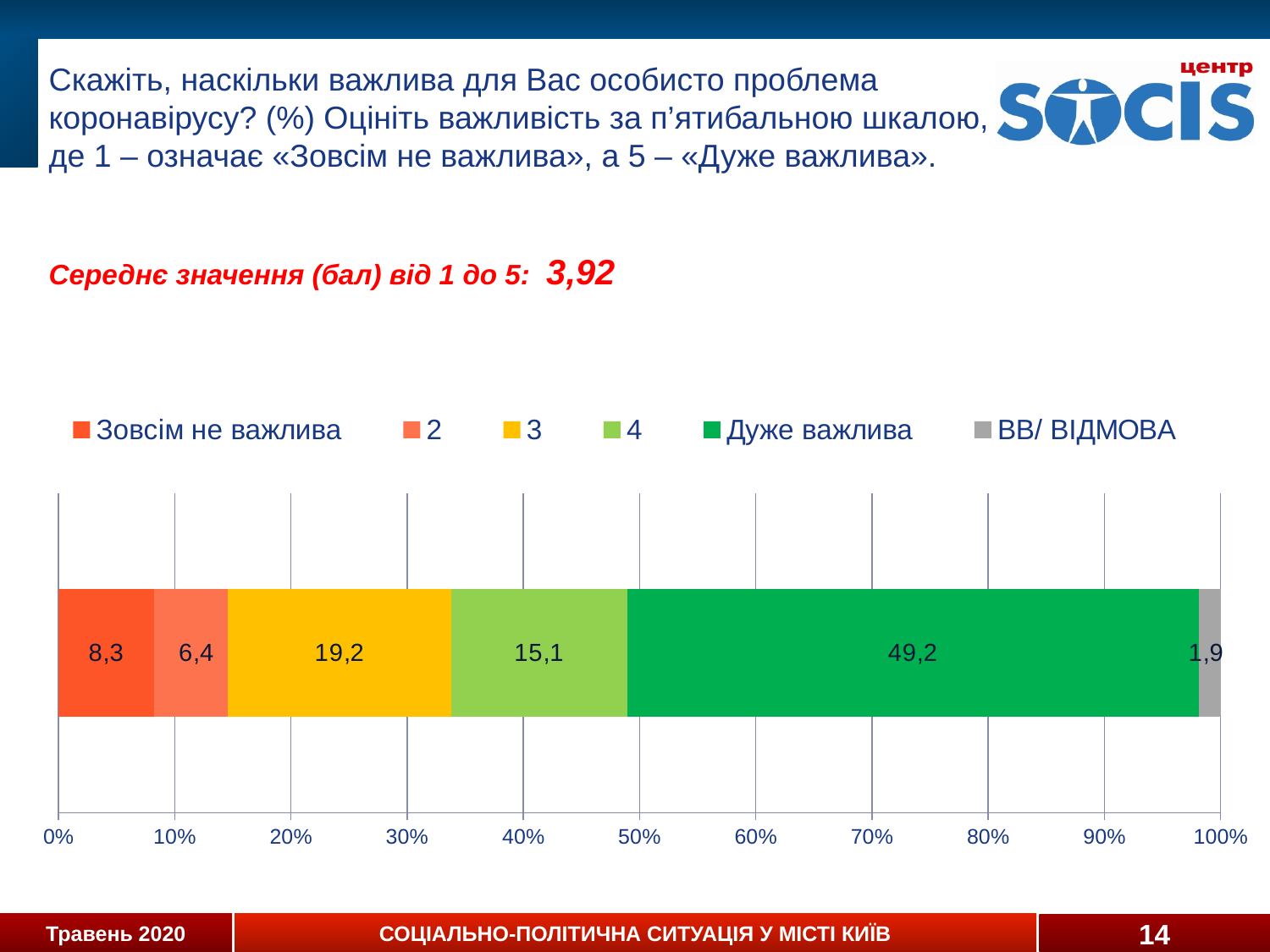
What is the value for «Дуже важлива»? 49,2 Which is larger, the value for «Зовсім не важлива» or the value for «2»? Зовсім не важлива Which segment has the highest value? Дуже важлива How many series does the legend list? 6 What is the value for «ВВ/ ВІДМОВА»? 1,9 What colour is the «Дуже важлива» segment? Green Which segment has the lowest value? ВВ/ ВІДМОВА What is the value for «Зовсім не важлива»? 8,3 What is the value for the «3» segment? 19,2 What kind of chart is shown on the slide? Stacked bar chart What is the difference between the values for «3» and «4»? 4,1 What is the total of the stacked bar? 100,1